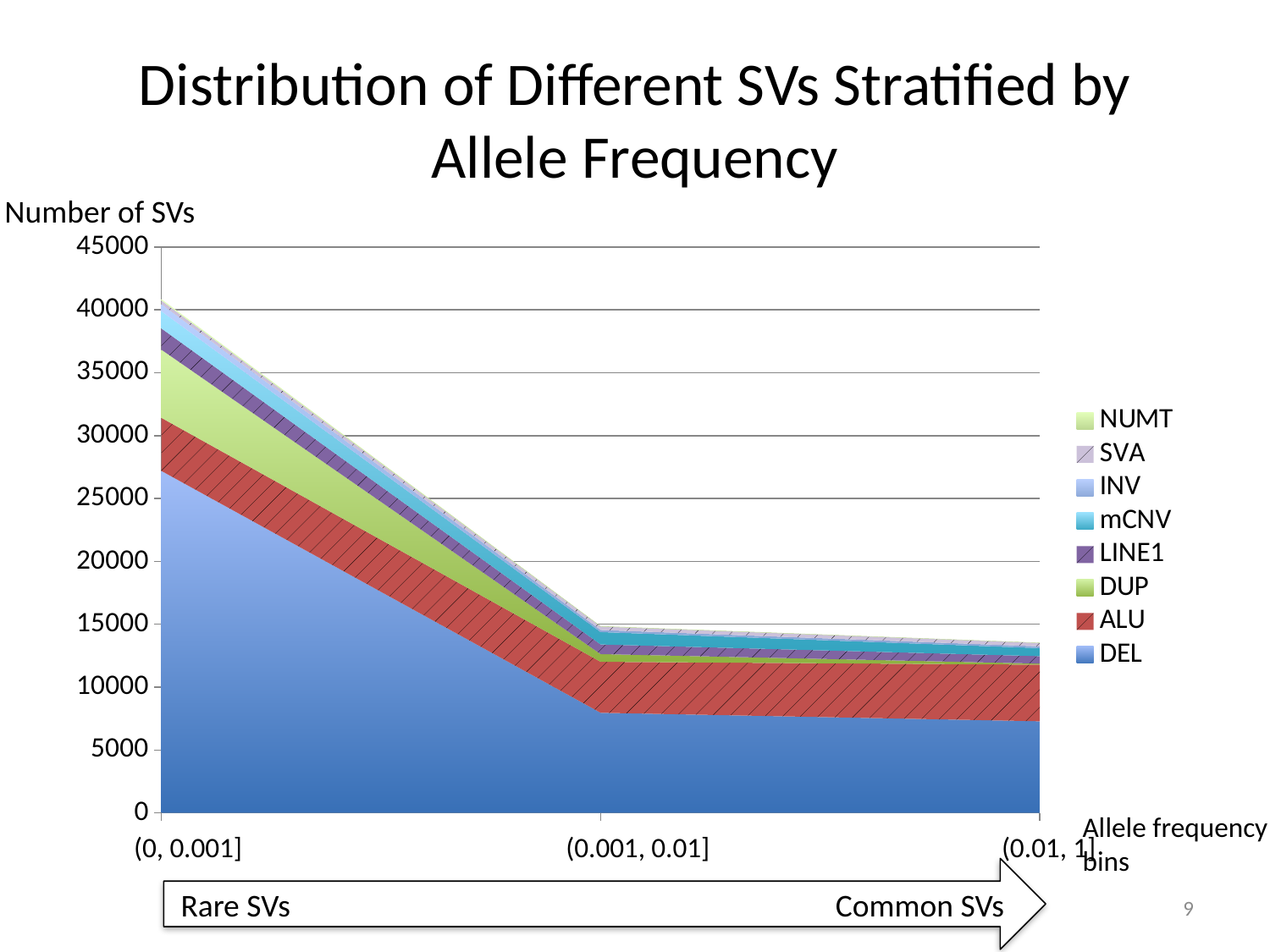
Which series contributes the largest number of SVs in the (0, 0.001] bin, DEL or ALU? DEL Which allele frequency bin has the lowest total number of SVs? (0.01, 1] How many series does the legend list? 8 Is the total number of SVs in the (0, 0.001] bin greater or less than 35000? greater Is the value for DEL in the (0.01, 1] bin greater or less than 10000? less What kind of chart is shown on the slide? Stacked area chart Does the total number of SVs rise or fall moving from the (0, 0.001] bin to the (0.01, 1] bin? Fall Is the value for DEL in the (0, 0.001] bin greater or less than 25000? greater What is the label on the vertical axis of the chart? Number of SVs Which allele frequency bin has the highest total number of SVs? (0, 0.001] How many allele frequency bins are plotted along the x axis? 3